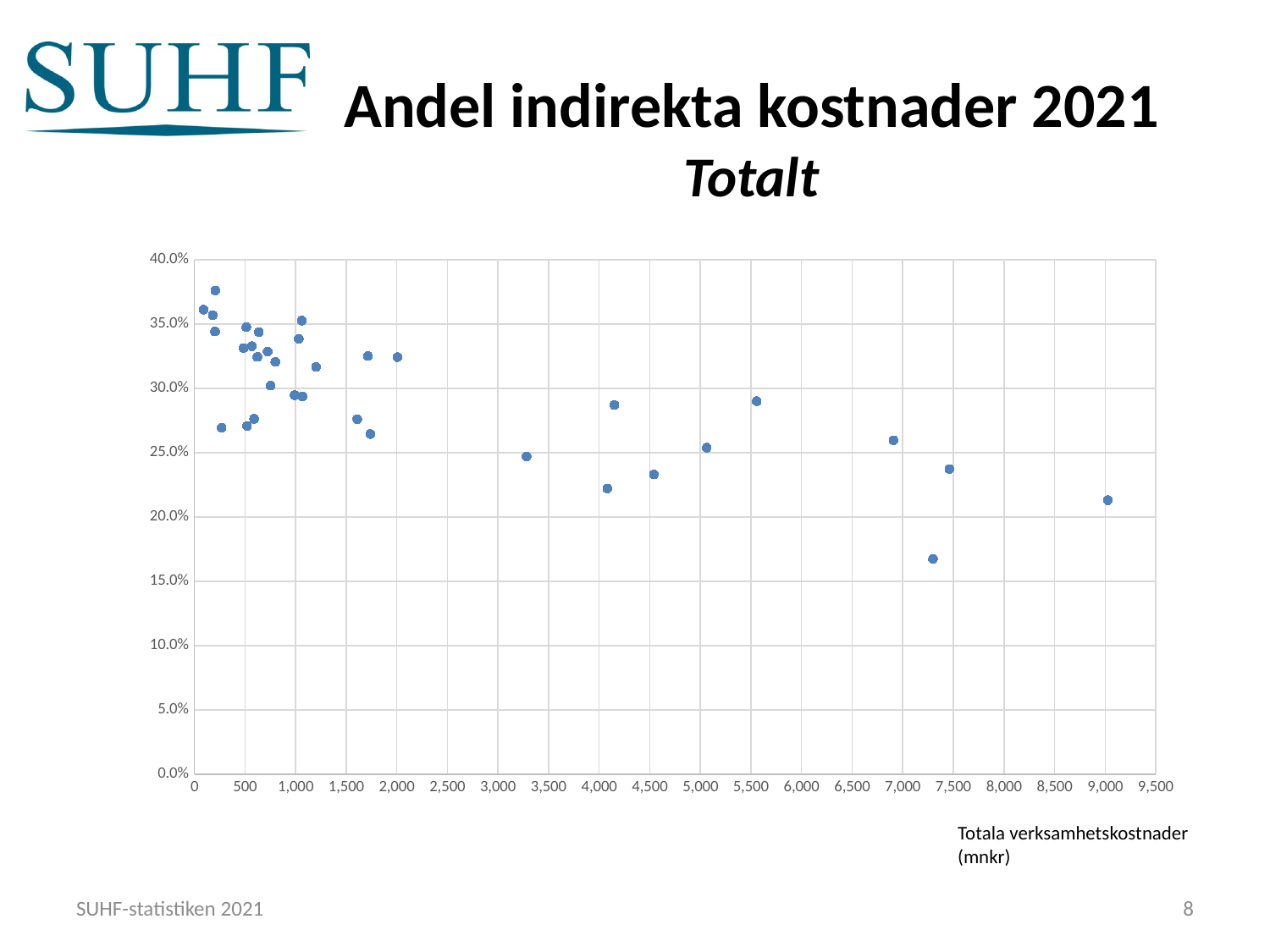
Do the plotted values generally rise or fall as the x-axis value (total costs) increases? Fall What is the title of the chart on the slide? Andel indirekta kostnader 2021 Totalt What kind of chart is shown on the slide? Scatter chart Is the value for the point near 3,300 on the x axis greater or less than 30.0%? less What is the highest value shown on the y axis of the chart? 40.0% Is the value for the rightmost point (at about 9,000 on the x axis) greater or less than 25.0%? less What is the label of the x axis of the chart? Totala verksamhetskostnader (mnkr) Is the value for the point near 5,500 on the x axis greater or less than 25.0%? greater Which point has the higher value: the one near 5,500 on the x axis or the one near 7,300 on the x axis? The one near 5,500